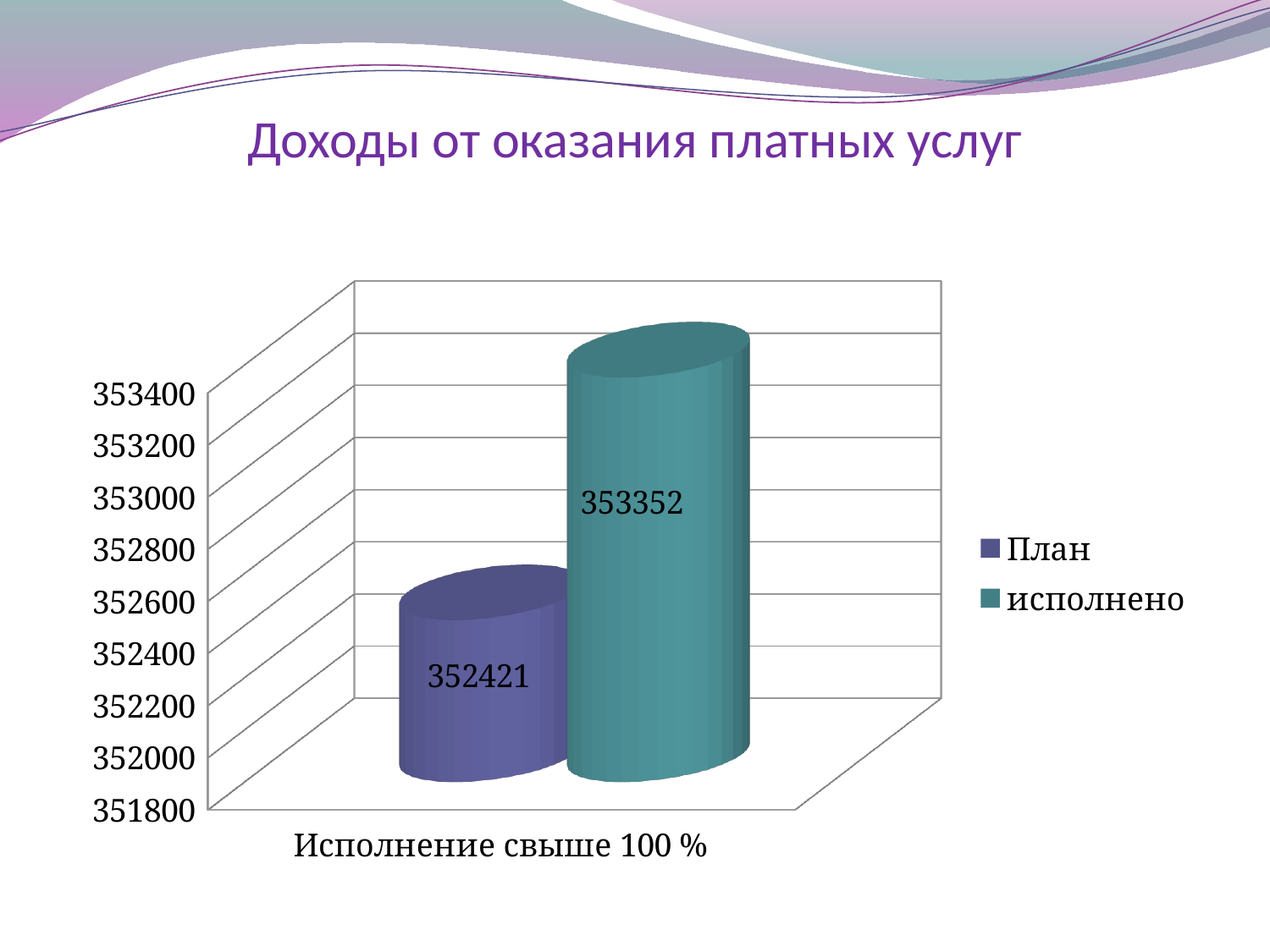
What kind of chart is shown on the slide? bar chart Which series has the higher value, План or исполнено? исполнено What is the category label shown on the x axis? Исполнение свыше 100 % Is the value for исполнено greater or less than 353000? greater Which series has the lowest value? План Is the value for План greater or less than 352600? less What is the difference between исполнено and План? 931 What is the value for План? 352421 What is the value for исполнено? 353352 What is the title of the slide? Доходы от оказания платных услуг How many categories are shown on the x axis? 1 How many series does the legend list? 2